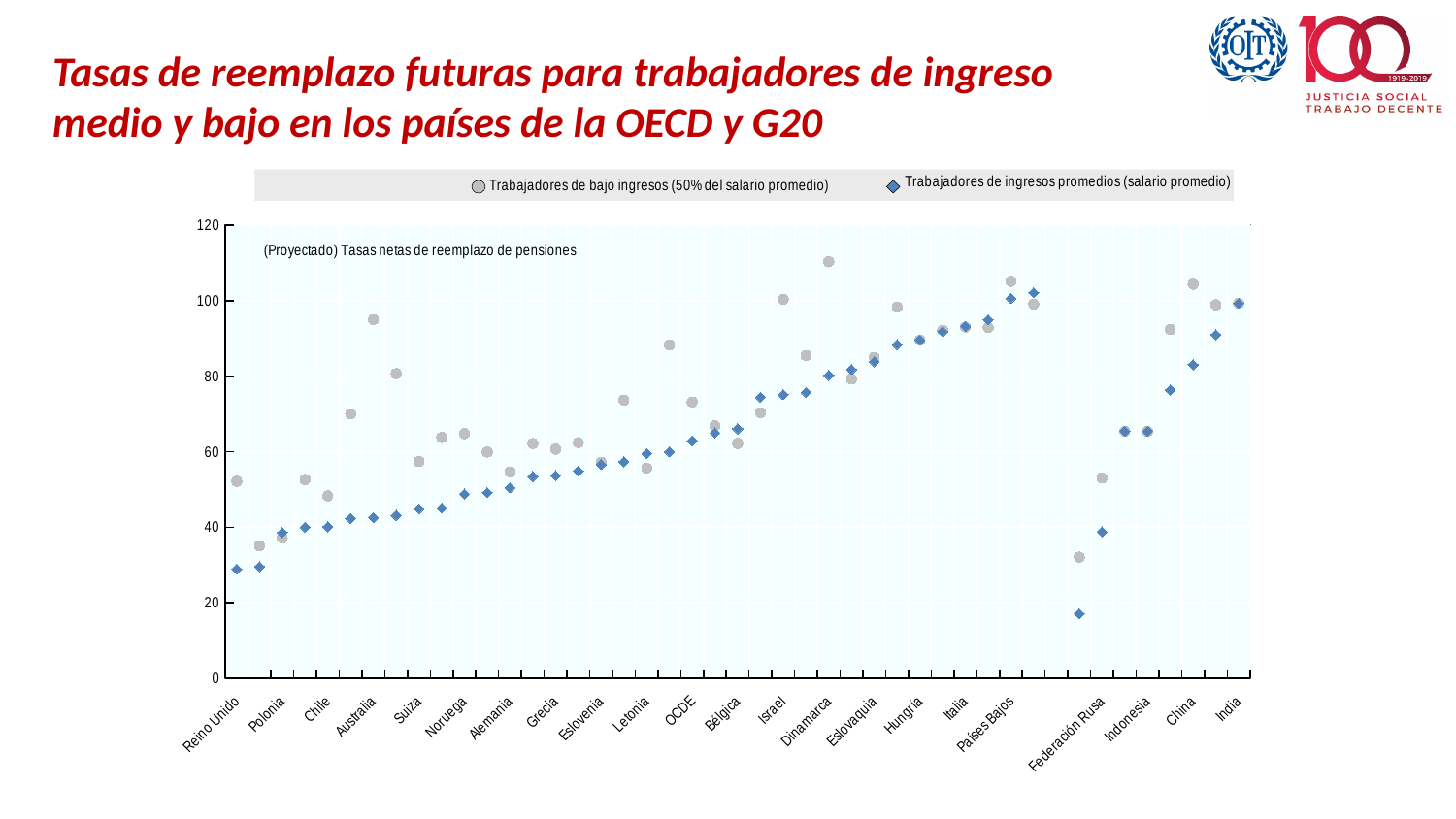
In the Trabajadores de ingresos promedios series, which is larger: Chile or Hungría? Hungría How many series does the legend list? 2 Is the value for India in the Trabajadores de ingresos promedios series greater or less than 80? greater Which country has the highest value for Trabajadores de bajo ingresos (50% del salario promedio)? Dinamarca For Australia, which series has the larger value: Trabajadores de bajo ingresos or Trabajadores de ingresos promedios? Trabajadores de bajo ingresos Is the value for Federación Rusa in the Trabajadores de ingresos promedios series greater or less than 20? greater What text appears inside the plot area at the top left of the chart? (Proyectado) Tasas netas de reemplazo de pensiones Do the values for Trabajadores de ingresos promedios generally rise or fall from Reino Unido to Países Bajos? rise What kind of chart is shown on the slide? Scatter (dot) chart Is the value for Reino Unido in the Trabajadores de ingresos promedios series greater or less than 40? less